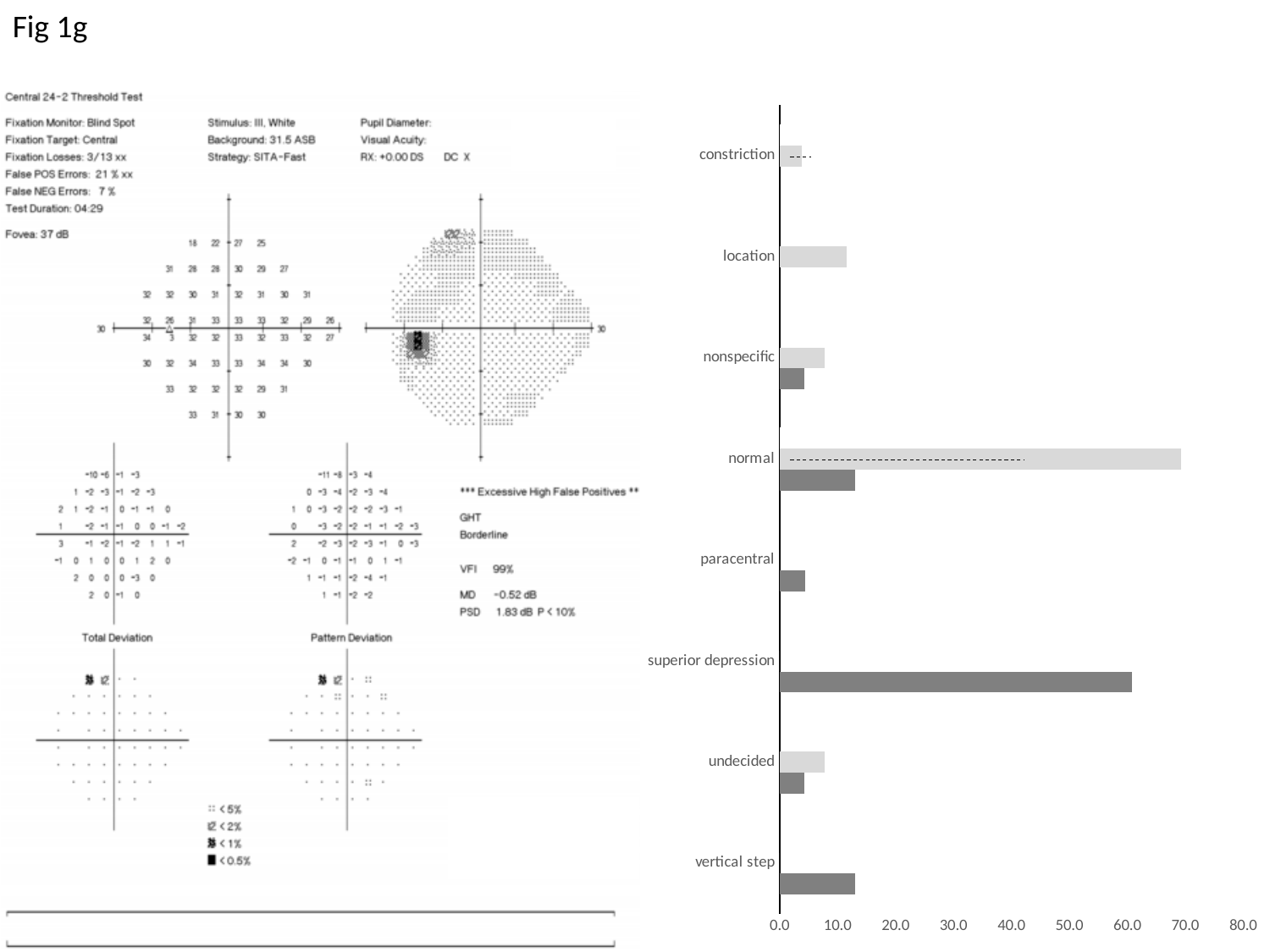
In the bar chart, is the light gray bar for normal greater or less than 60.0? greater In the bar chart, which category has the shortest light gray bar? constriction In the bar chart, which category has the longest light gray bar? normal In the bar chart, which is larger: the light gray bar for location or the light gray bar for constriction? location How many categories are listed on the vertical axis of the bar chart? 8 In the bar chart, is the light gray bar for constriction greater or less than 10.0? less In the bar chart, is the dark gray bar for superior depression greater or less than 50.0? greater In the bar chart, which is larger: the light gray bar for normal or the dark gray bar for superior depression? normal What is the highest value shown on the horizontal axis of the bar chart? 80.0 In the bar chart, which category has the longest dark gray bar? superior depression What kind of chart is shown on the right side of the slide? bar chart